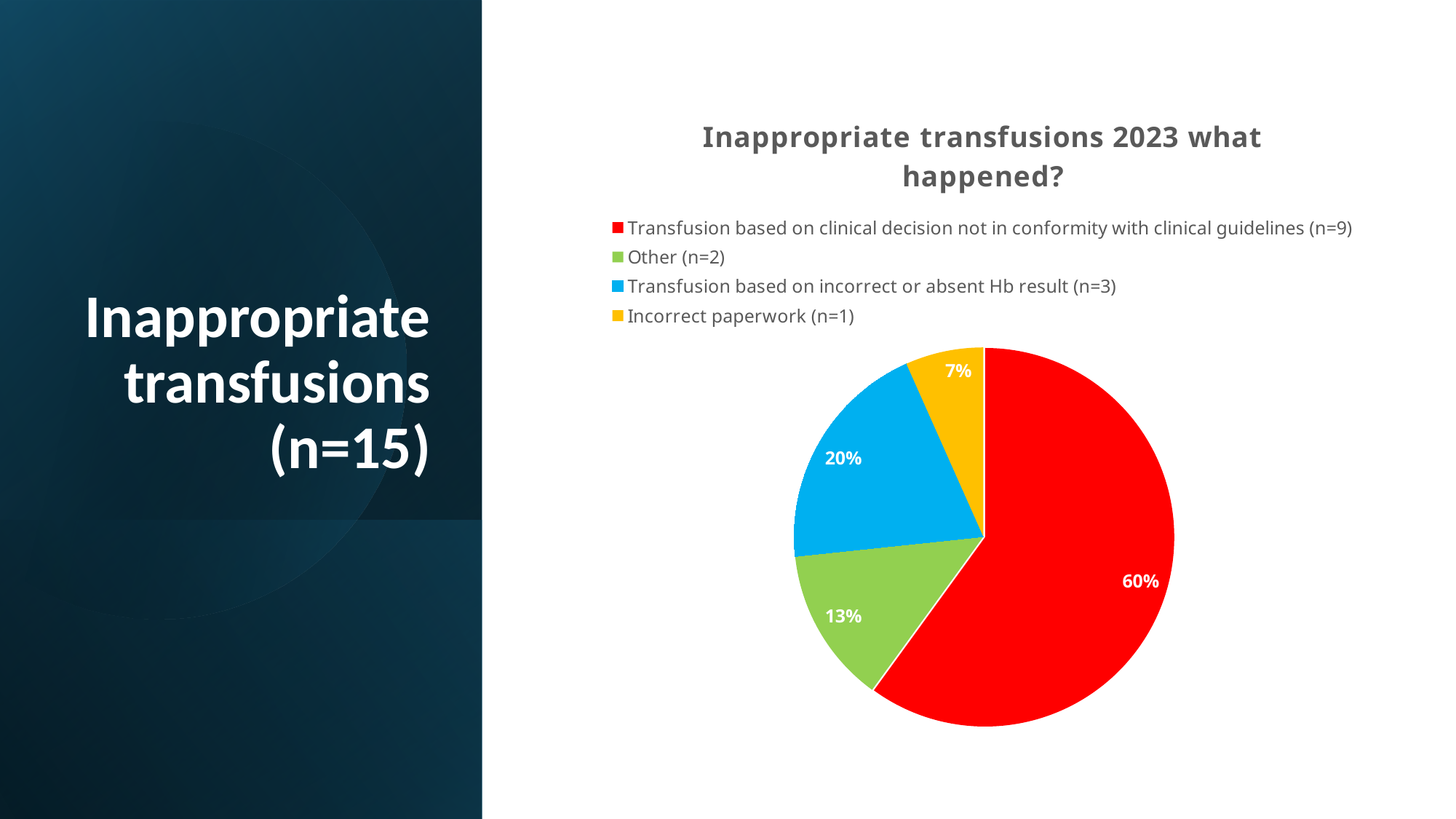
Which category has the smallest slice of the pie? Incorrect paperwork (n=1) What is the title of the chart? Inappropriate transfusions 2023 what happened? What is the difference in percentage points between the 'Transfusion based on incorrect or absent Hb result (n=3)' slice and the 'Other (n=2)' slice? 7 What share of the pie is 'Incorrect paperwork (n=1)'? 7% Which category has the largest slice of the pie? Transfusion based on clinical decision not in conformity with clinical guidelines (n=9) What share of the pie is 'Other (n=2)'? 13% What share of the pie is 'Transfusion based on incorrect or absent Hb result (n=3)'? 20% What kind of chart is shown on the slide? pie chart Which slice is larger: 'Other (n=2)' or 'Transfusion based on incorrect or absent Hb result (n=3)'? Transfusion based on incorrect or absent Hb result (n=3) What colour is the slice for 'Incorrect paperwork (n=1)'? yellow How many slices does the pie chart have? 4